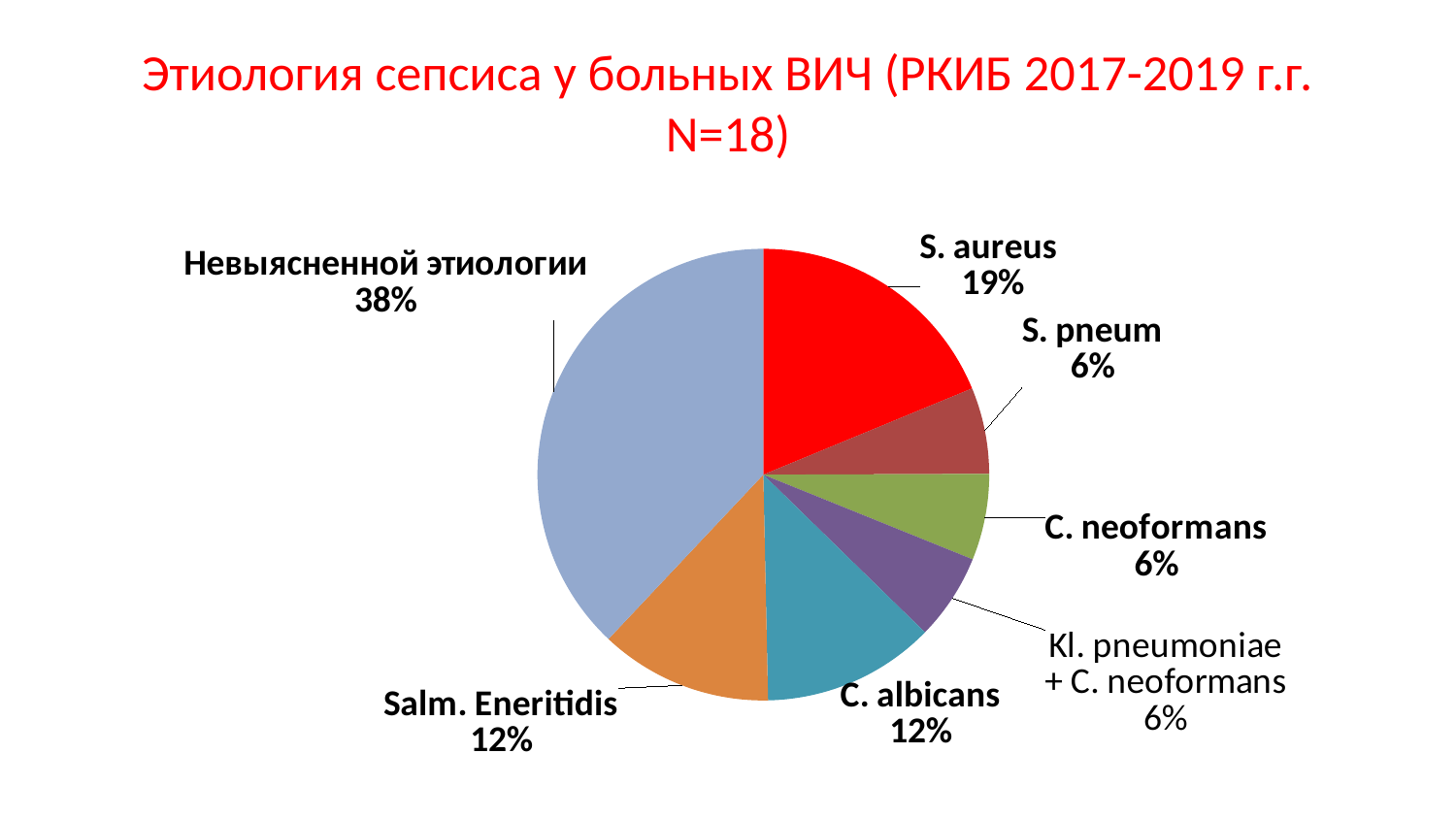
Which category has the largest slice of the pie? Невыясненной этиологии Which is larger, the share for S. aureus or the share for Salm. Eneritidis? S. aureus What colour is the S. aureus slice? red What percentage is shown for Kl. pneumoniae + C. neoformans? 6% What is the difference between the shares of C. albicans and S. pneum? 6% What share of the pie does S. aureus account for? 19% What kind of chart is shown on the slide? pie chart What percentage is shown for C. albicans? 12% What is the title of the chart on the slide? Этиология сепсиса у больных ВИЧ (РКИБ 2017-2019 г.г. N=18) How many slices does the pie chart have? 7 What is the value shown for Невыясненной этиологии? 38% What is the difference between the shares of Невыясненной этиологии and S. aureus? 19%